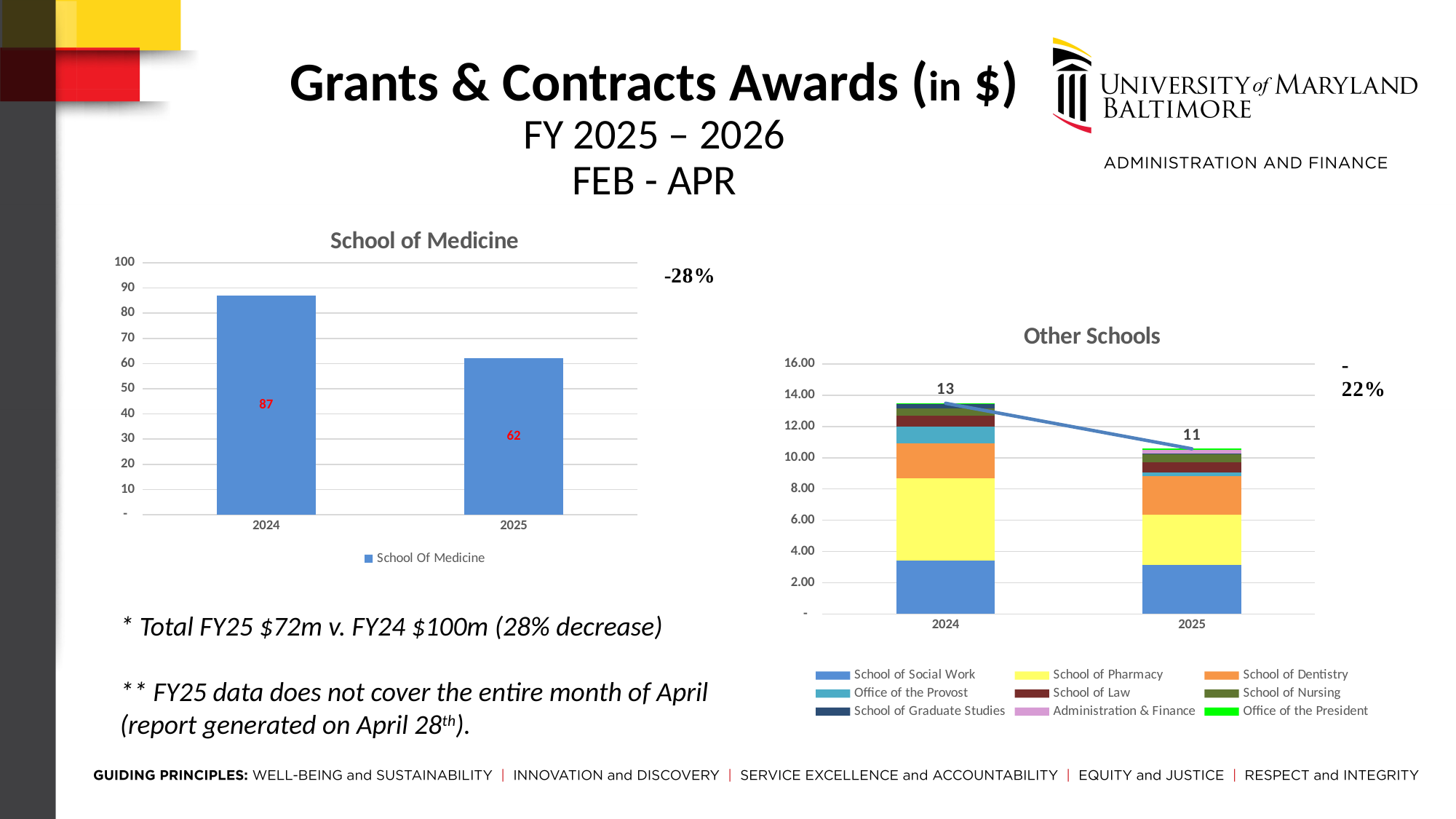
In the Other Schools chart, what is the total of the stacked bar for 2025? 11 In the Other Schools chart, how many series does the legend list? 9 In the School of Medicine chart, what is the value for 2024? 87 In the School of Medicine chart, what is the difference between the 2024 and 2025 values? 25 In the Other Schools chart, is the School of Social Work value for 2024 greater or less than 4.00? less In the School of Medicine chart, what is the value for 2025? 62 In the School of Medicine chart, which year has the higher value? 2024 In the Other Schools chart, which series is shown in yellow? School of Pharmacy In the Other Schools chart, what is the total of the stacked bar for 2024? 13 In the School of Medicine chart, do the values rise or fall from 2024 to 2025? fall In the Other Schools chart, which year has the lower stacked total? 2025 What kind of chart is the School of Medicine chart? bar chart